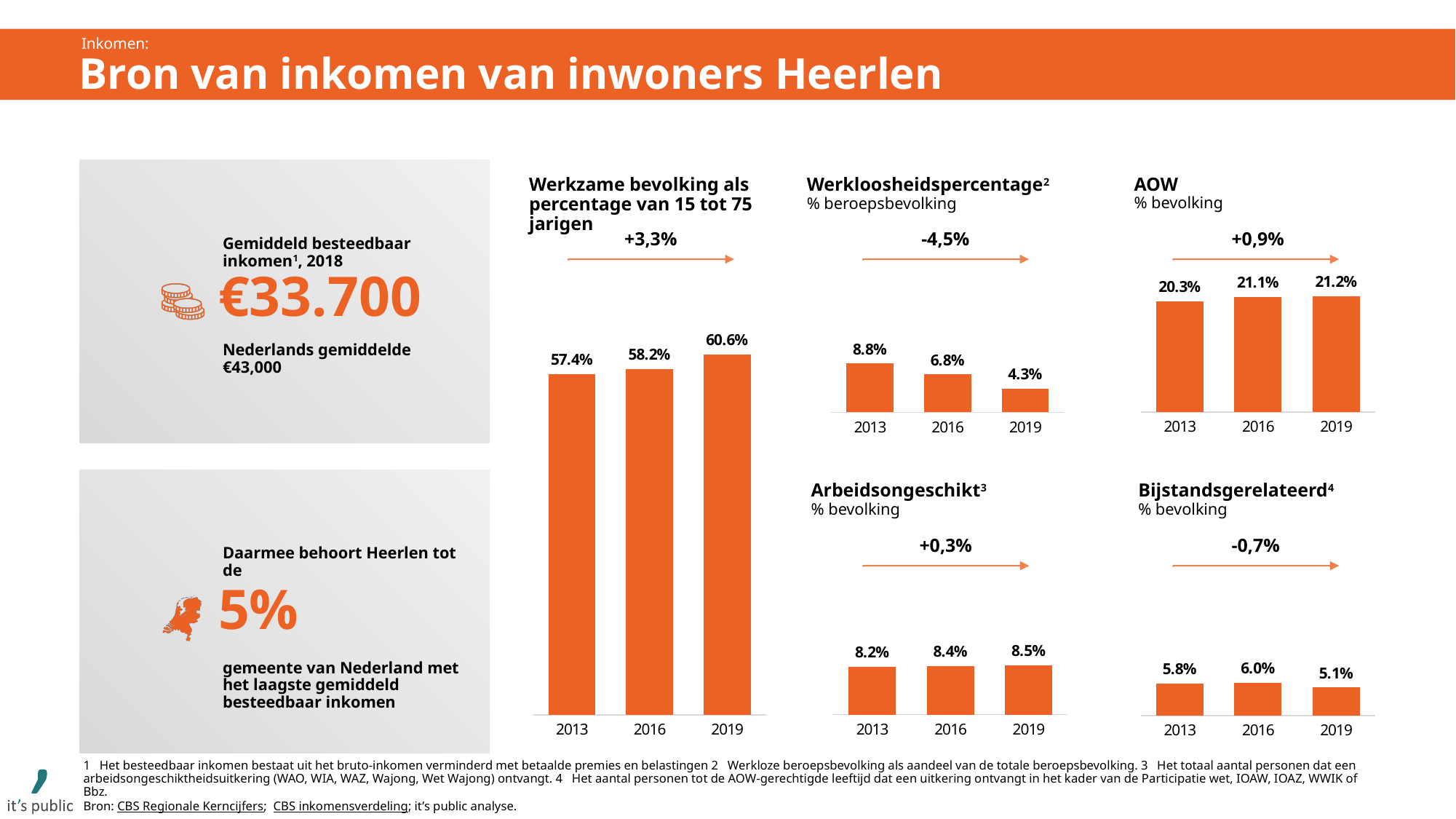
In the 'Werkloosheidspercentage' chart, what is the value for 2013? 8.8% How many bars are shown in the 'AOW' chart? 3 In the 'Werkloosheidspercentage' chart, which year has the lowest value? 2019 In the 'AOW' chart, what is the value for 2016? 21.1% In the 'Werkzame bevolking als percentage van 15 tot 75 jarigen' chart, what is the value for 2019? 60.6% What type of chart is the 'Bijstandsgerelateerd' chart? bar chart How many bar charts are shown on the slide? 5 In the 'Bijstandsgerelateerd' chart, which year has the highest value? 2016 In the 'Werkloosheidspercentage' chart, what is the difference between the 2013 and 2019 values? 4.5% In the 'Werkzame bevolking als percentage van 15 tot 75 jarigen' chart, what is the difference between the 2019 and 2013 values? 3.2% In the 'Werkloosheidspercentage' chart, do the values rise or fall from 2013 to 2019? fall In the 'Arbeidsongeschikt' chart, which is larger: the value for 2013 or the value for 2019? 2019